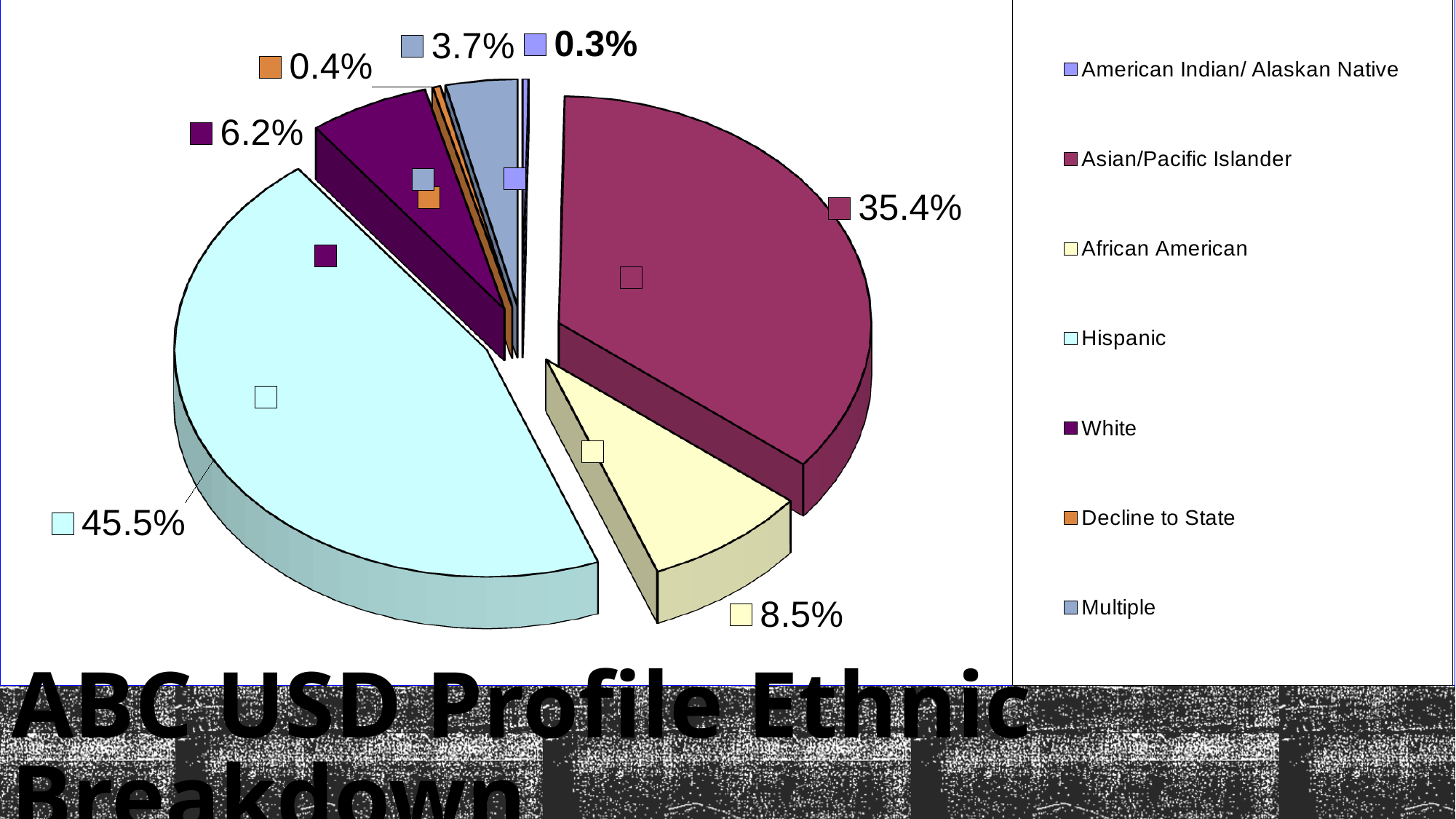
What percentage of the pie is African American? 8.5% Which category has the largest share of the pie? Hispanic How many categories does the legend list? 7 What percentage of the pie is Decline to State? 0.4% What type of chart is shown on the slide? Pie chart What is the difference in percentage points between the Hispanic and Asian/Pacific Islander slices? 10.1 Which category has the smallest share of the pie? American Indian/ Alaskan Native Which is larger, the Multiple slice or the White slice? White What is the title of the slide? ABC USD Profile Ethnic Breakdown What percentage of the pie is Asian/Pacific Islander? 35.4% What percentage of the pie is Hispanic? 45.5% What percentage of the pie is White? 6.2%